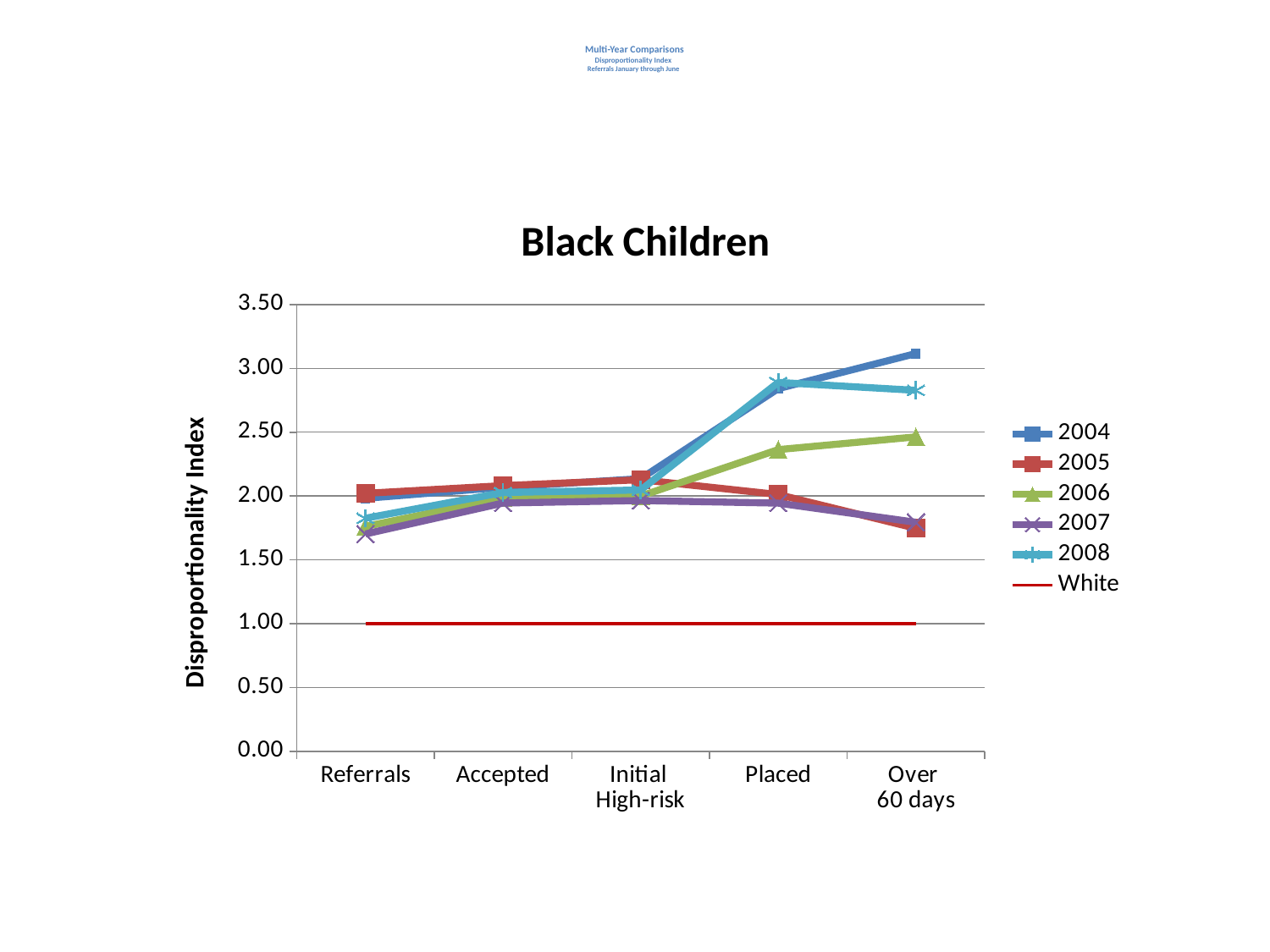
Does the 2004 line rise or fall from Referrals to Over 60 days? rise How many series does the legend list? 6 What value does the White line sit at across all categories? 1.00 What is the label of the vertical axis? Disproportionality Index How many categories are shown on the x axis? 5 Is the value for 2006 at Placed greater or less than 2.00? greater Is the value for 2005 at Over 60 days greater or less than 2.00? less What is the title of the chart? Black Children Which series has the highest value at Over 60 days? 2004 At Placed, which is larger, the value for 2004 or the value for 2005? 2004 Is the value for 2004 at Over 60 days greater or less than 3.00? greater What kind of chart is shown on the slide? line chart